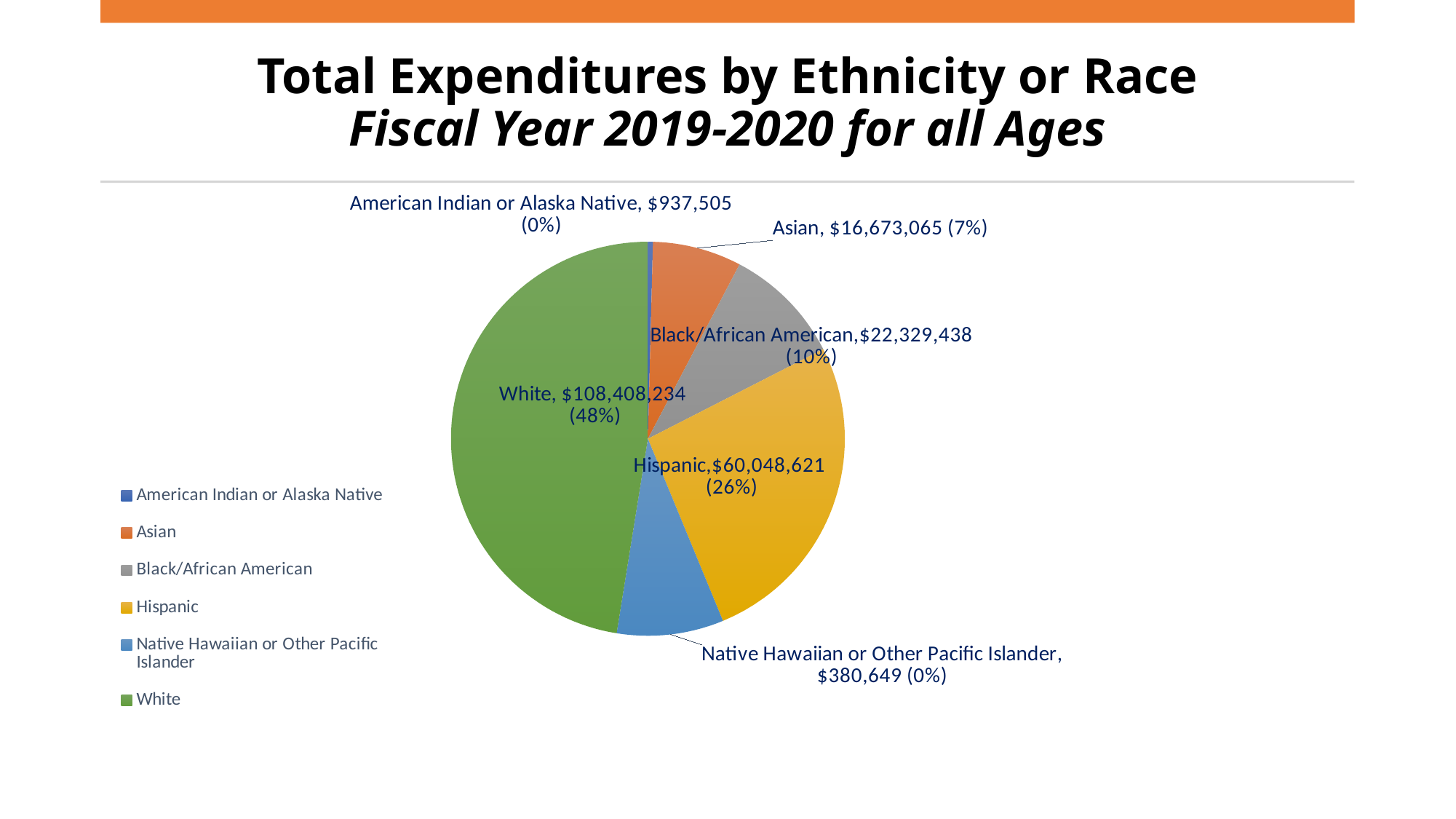
What share of total expenditures does White represent? 48% What is the total expenditure for American Indian or Alaska Native? $937,505 What is the difference between the expenditures for White and Hispanic? $48,359,613 What type of chart is shown on the slide? Pie chart Which is larger, the expenditure for Black/African American or for Asian? Black/African American Which colour represents Hispanic in the pie chart? Yellow What share of total expenditures does Black/African American represent? 10% Which category has the largest share of total expenditures? White What is the total expenditure for Asian? $16,673,065 How many categories are shown in the pie chart? 6 What is the total expenditure for Hispanic? $60,048,621